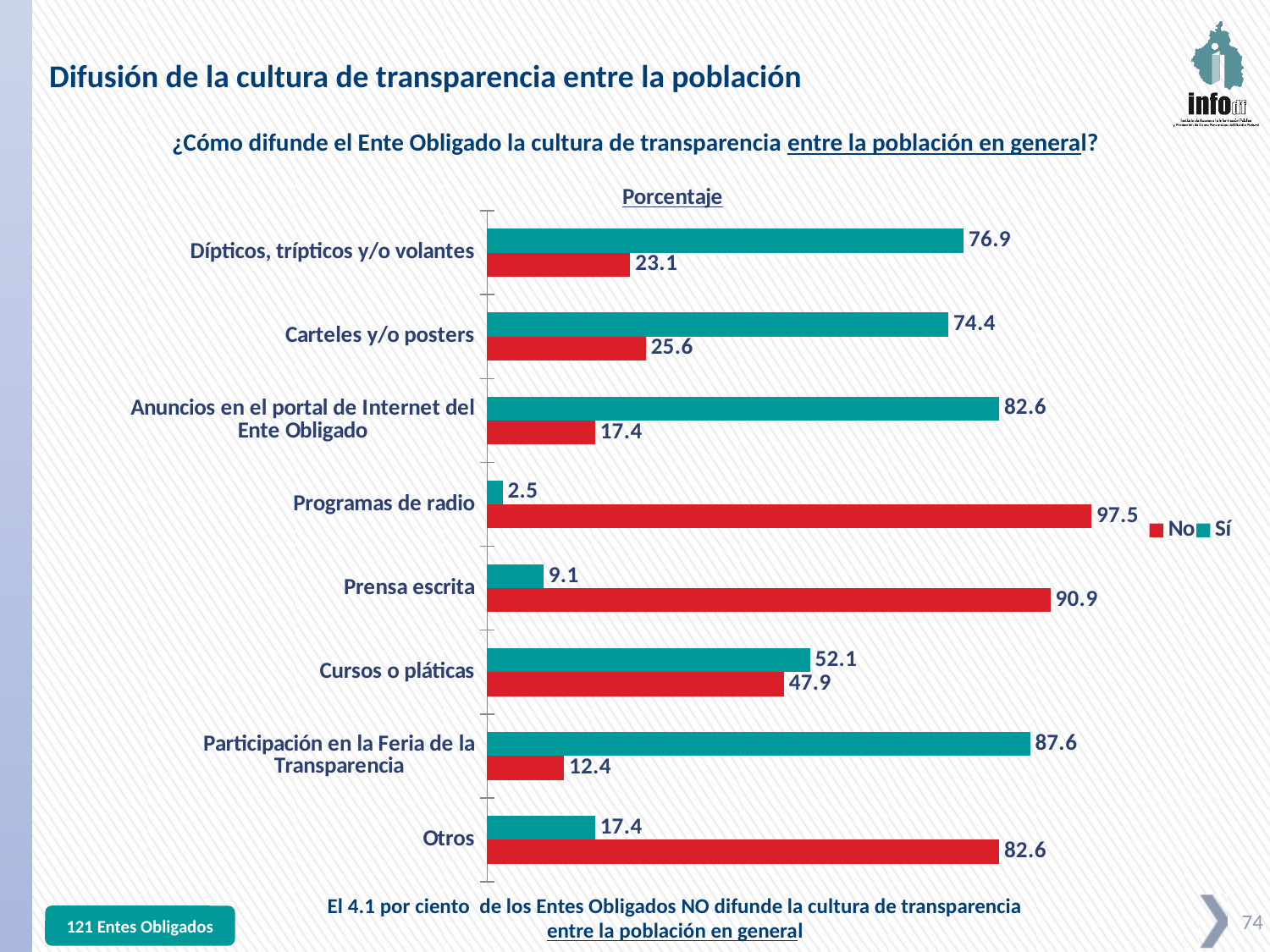
What is the difference between the 'Sí' and 'No' values for 'Dípticos, trípticos y/o volantes'? 53.8 Which category has the highest 'Sí' value? Participación en la Feria de la Transparencia What is the 'Sí' value for 'Anuncios en el portal de Internet del Ente Obligado'? 82.6 What is the 'No' value for 'Otros'? 82.6 What kind of chart is shown on the slide? Bar chart How many series does the legend list? 2 Which category has the lowest 'Sí' value? Programas de radio What is the 'No' value for 'Programas de radio'? 97.5 How many categories are shown on the chart? 8 What colour represents the 'No' series in the chart? Red Which is larger for 'Prensa escrita', the 'Sí' value or the 'No' value? No What is the 'Sí' value for 'Cursos o pláticas'? 52.1